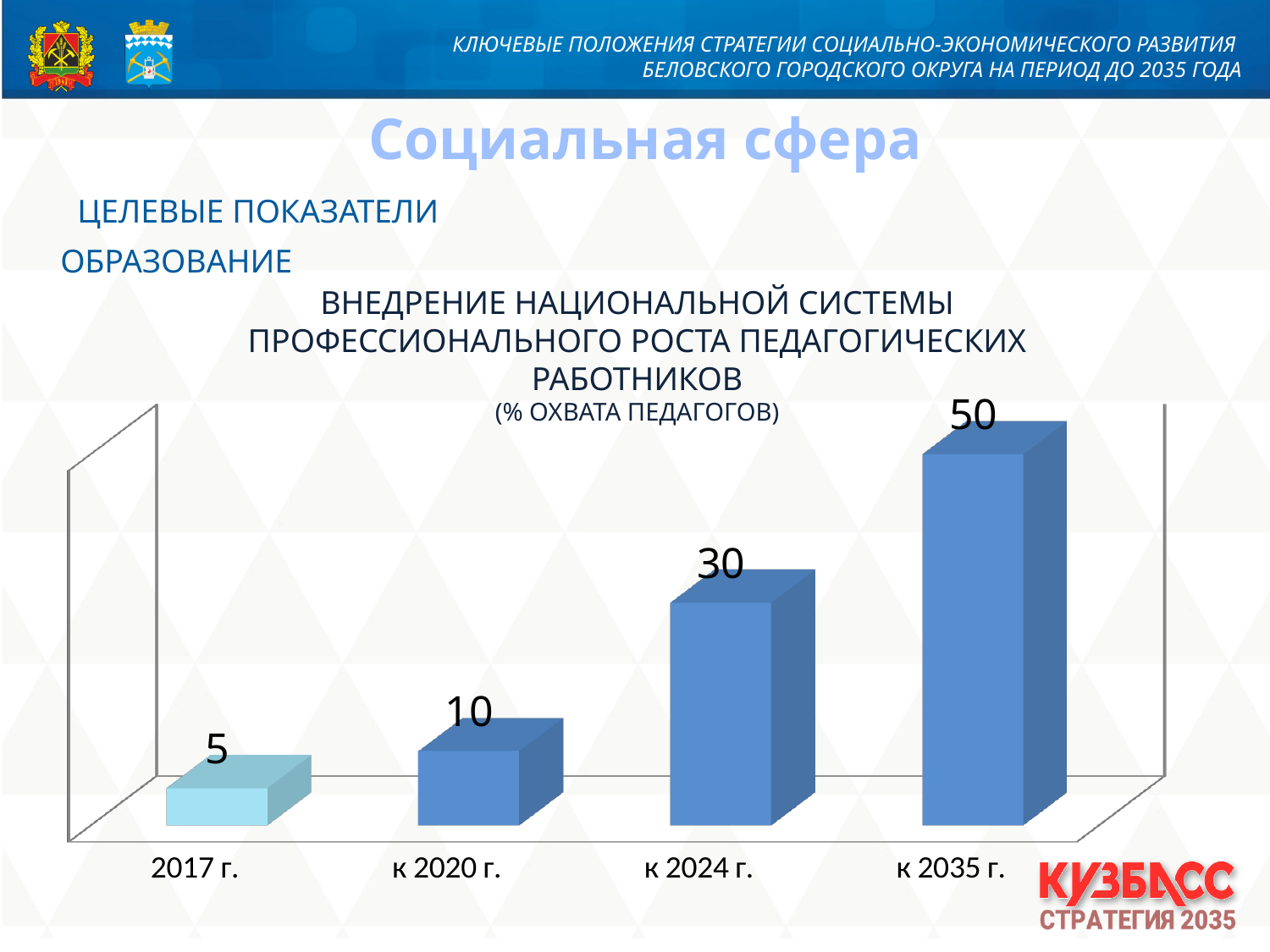
Which is larger, the value for к 2024 г. or the value for к 2020 г.? к 2024 г. What is the value for к 2035 г.? 50 What is the difference between the values for к 2020 г. and 2017 г.? 5 Which category has the highest value? к 2035 г. Do the values rise or fall from 2017 г. to к 2035 г.? rise What is the value for к 2024 г.? 30 What is the difference between the values for к 2035 г. and к 2024 г.? 20 What kind of chart is shown? bar chart What is the value for к 2020 г.? 10 Which category has the lowest value? 2017 г. How many categories are shown on the x axis? 4 What is the value for 2017 г.? 5